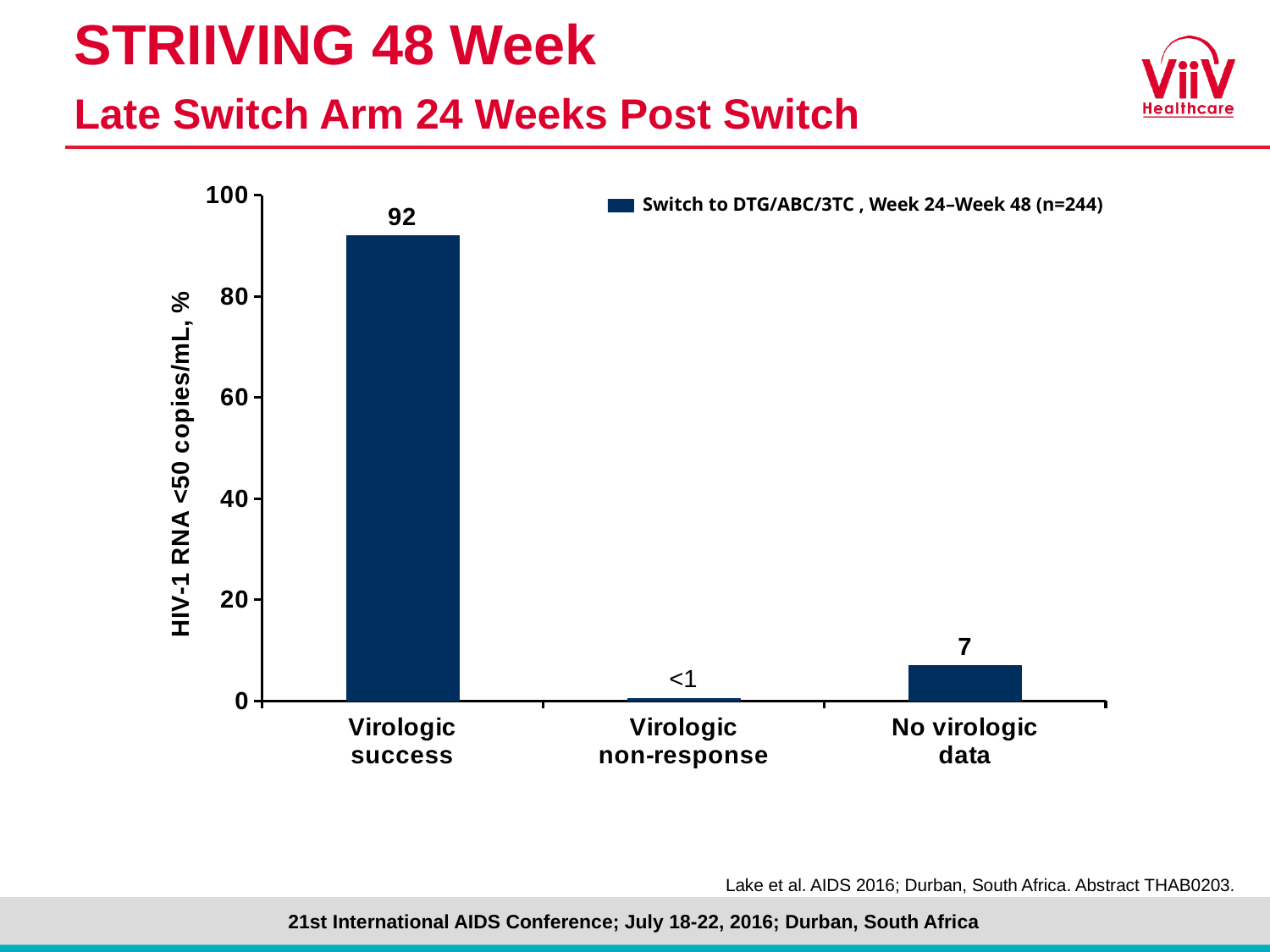
What is the label of the y axis? HIV-1 RNA <50 copies/mL, % What is the value shown for Virologic non-response? <1 What is the value for No virologic data? 7 What kind of chart is shown on the slide? bar chart How many series does the legend list? 1 Which category has the lowest value? Virologic non-response What is the difference between the values for Virologic success and No virologic data? 85 Which category has the highest value? Virologic success What is the value for Virologic success? 92 How many categories are shown on the x axis? 3 Is the value for Virologic success greater or less than 80? greater Which is larger, the value for No virologic data or the value for Virologic non-response? No virologic data